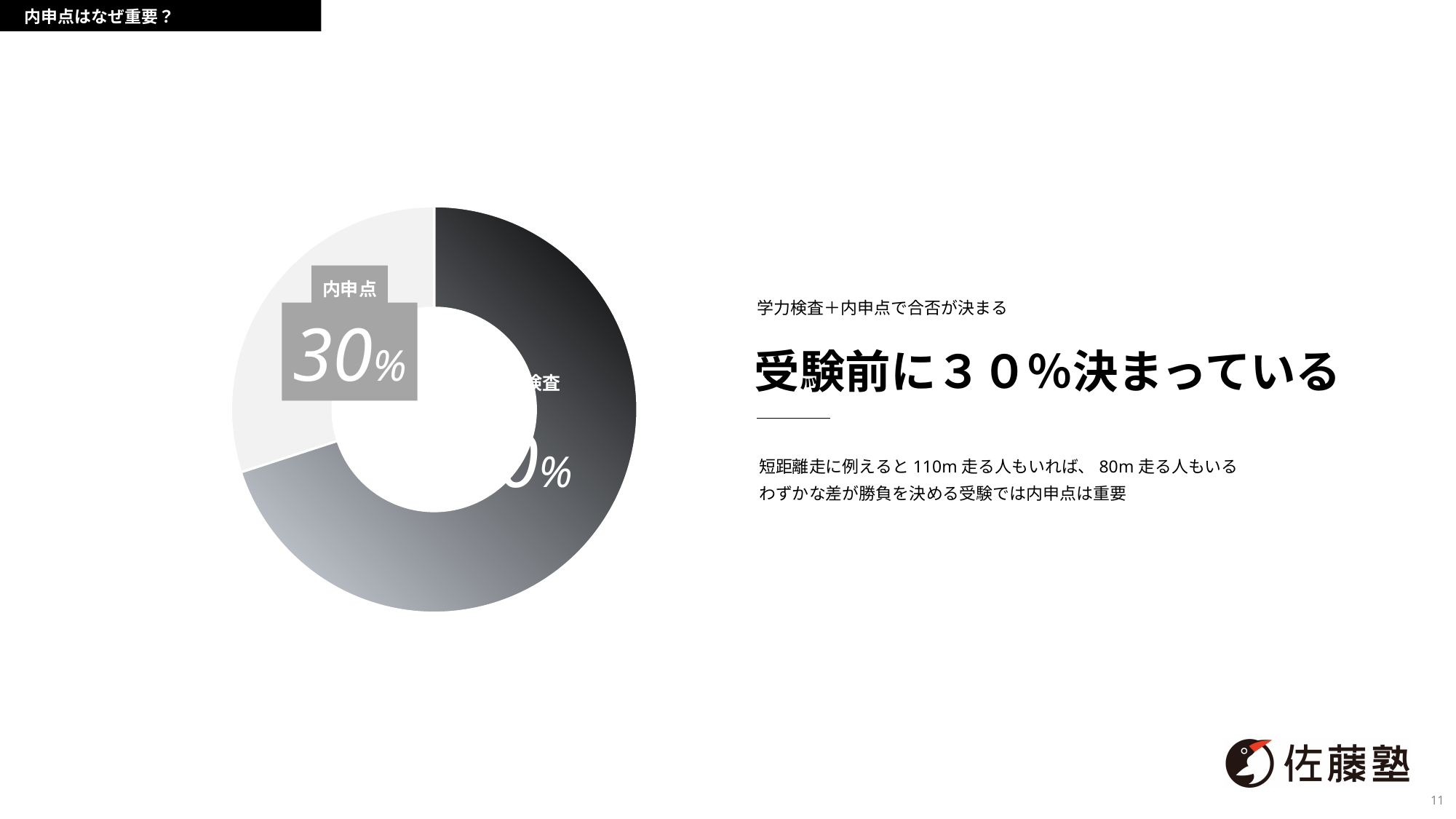
How many slices does the donut chart have? 2 What kind of chart is shown on the slide? Pie chart (donut) What colour is the 内申点 slice in the donut chart? Light gray What share of the donut chart does the 内申点 slice represent? 30% Which slice of the donut chart is the smallest? 内申点 What is the title shown in the top-left header of the slide? 内申点はなぜ重要？ Is the 内申点 slice larger or smaller than the dark slice in the donut chart? smaller What percentage is shown for 内申点 in the donut chart? 30% Is the value for 内申点 greater or less than 50%? less